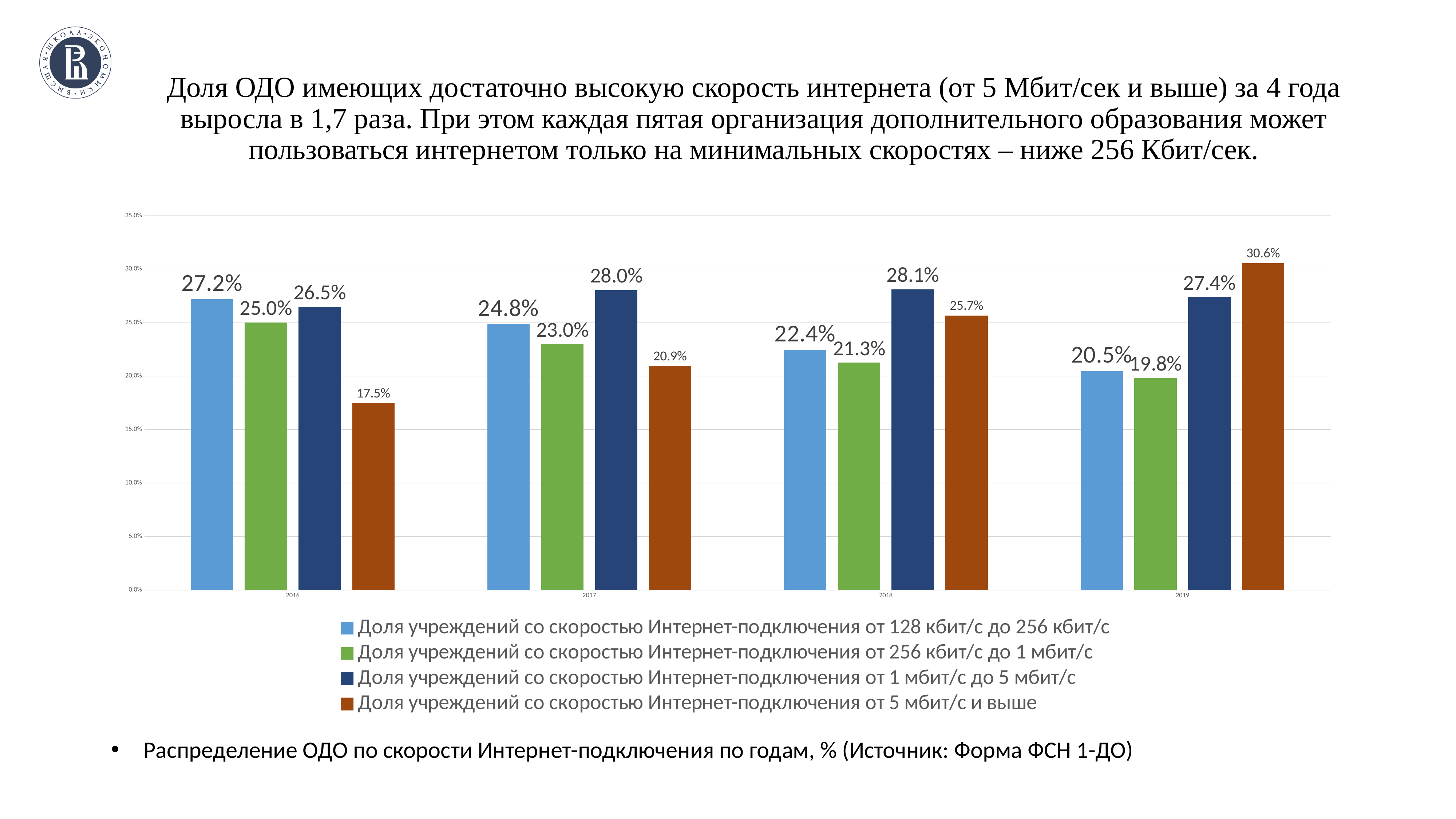
What is the value for 'Доля учреждений со скоростью Интернет-подключения от 5 мбит/с и выше' in 2016? 17.5% In which year is the value for 'Доля учреждений со скоростью Интернет-подключения от 256 кбит/с до 1 мбит/с' lowest? 2019 What is the value for 'Доля учреждений со скоростью Интернет-подключения от 128 кбит/с до 256 кбит/с' in 2019? 20.5% How many years are shown on the x axis? 4 How many series does the legend list? 4 What is the value for 'Доля учреждений со скоростью Интернет-подключения от 1 мбит/с до 5 мбит/с' in 2018? 28.1% What colour are the bars for 'Доля учреждений со скоростью Интернет-подключения от 5 мбит/с и выше'? brown What type of chart is shown on the slide? bar chart Which is larger in 2017: the value for 'от 128 кбит/с до 256 кбит/с' or the value for 'от 5 мбит/с и выше'? от 128 кбит/с до 256 кбит/с How does the value for 'Доля учреждений со скоростью Интернет-подключения от 128 кбит/с до 256 кбит/с' change from 2016 to 2019? falls What is the difference between the 2019 and 2016 values for 'Доля учреждений со скоростью Интернет-подключения от 5 мбит/с и выше'? 13.1% In which year is the value for 'Доля учреждений со скоростью Интернет-подключения от 5 мбит/с и выше' highest? 2019